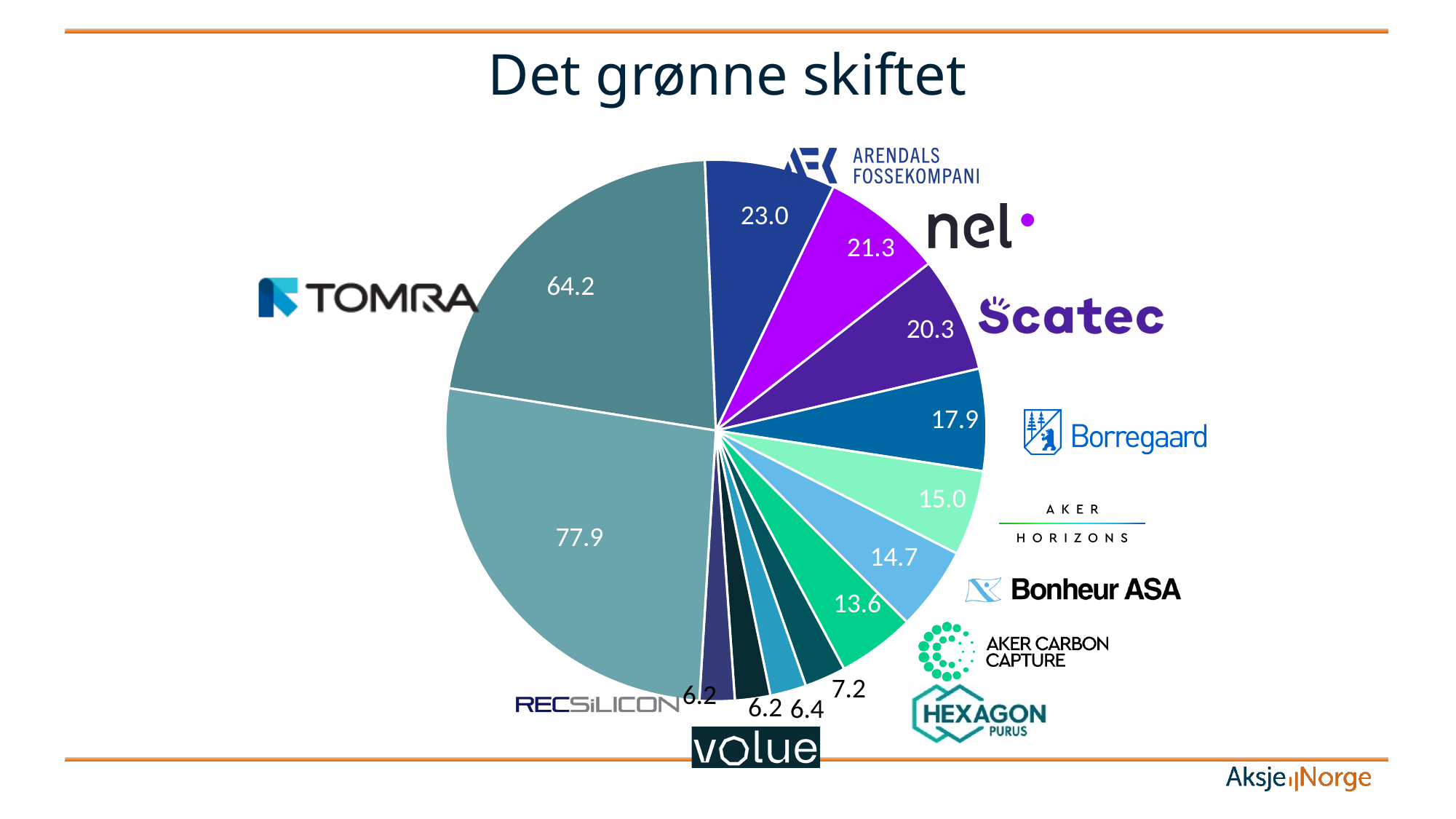
What is the largest value labelled on the pie chart? 77.9 Which is larger: the slice labelled 77.9 or the slice labelled 64.2? 77.9 What is the difference between the slice labelled 23.0 and the slice labelled 21.3? 1.7 What is the difference between the two largest slices, 77.9 and 64.2? 13.7 What is the value of the slice next to the Scatec logo? 20.3 What is the value of the slice next to the Arendals Fossekompani logo? 23.0 How many slices does the pie chart have? 13 What is the smallest value labelled on the pie chart? 6.2 What kind of chart is shown on the slide? pie chart What is the value of the slice next to the Borregaard logo? 17.9 What is the value of the slice next to the TOMRA logo? 64.2 What is the title of the slide with the pie chart? Det grønne skiftet